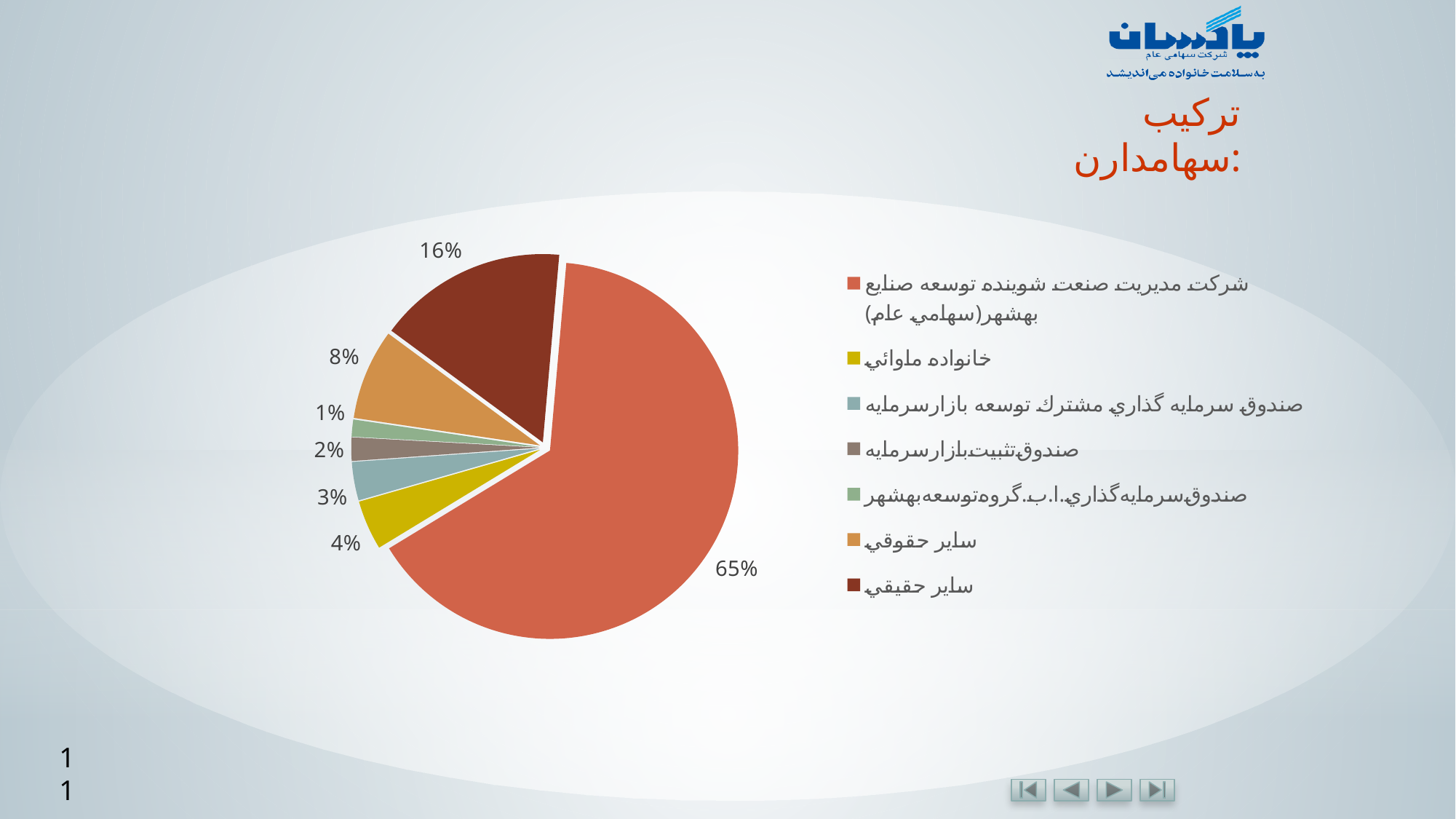
How many slices does the pie chart have? 7 What is the difference between the share for سایر حقیقی and the share for سایر حقوقی? 8% What kind of chart is shown on the slide? pie chart How many entries does the legend list? 7 Which is larger, the slice for خانواده ملوانی or the slice for صندوق سرمایه گذاری مشترک توسعه بازار سرمایه? خانواده ملوانی Which category has the largest slice of the pie? شرکت مدیریت صنعت شوینده توسعه صنایع بهشهر(سهامی عام) What colour is the slice for سایر حقیقی? dark red What is the value shown for خانواده ملوانی? 4% What is the value shown for صندوق تثبیت بازار سرمایه? 2% What share of the pie does the slice for سایر حقیقی represent? 16% Which category has the smallest slice of the pie? صندوق سرمایه گذاری.ا.ب.گروه توسعه بهشهر What share of the pie does the slice for سایر حقوقی represent? 8%